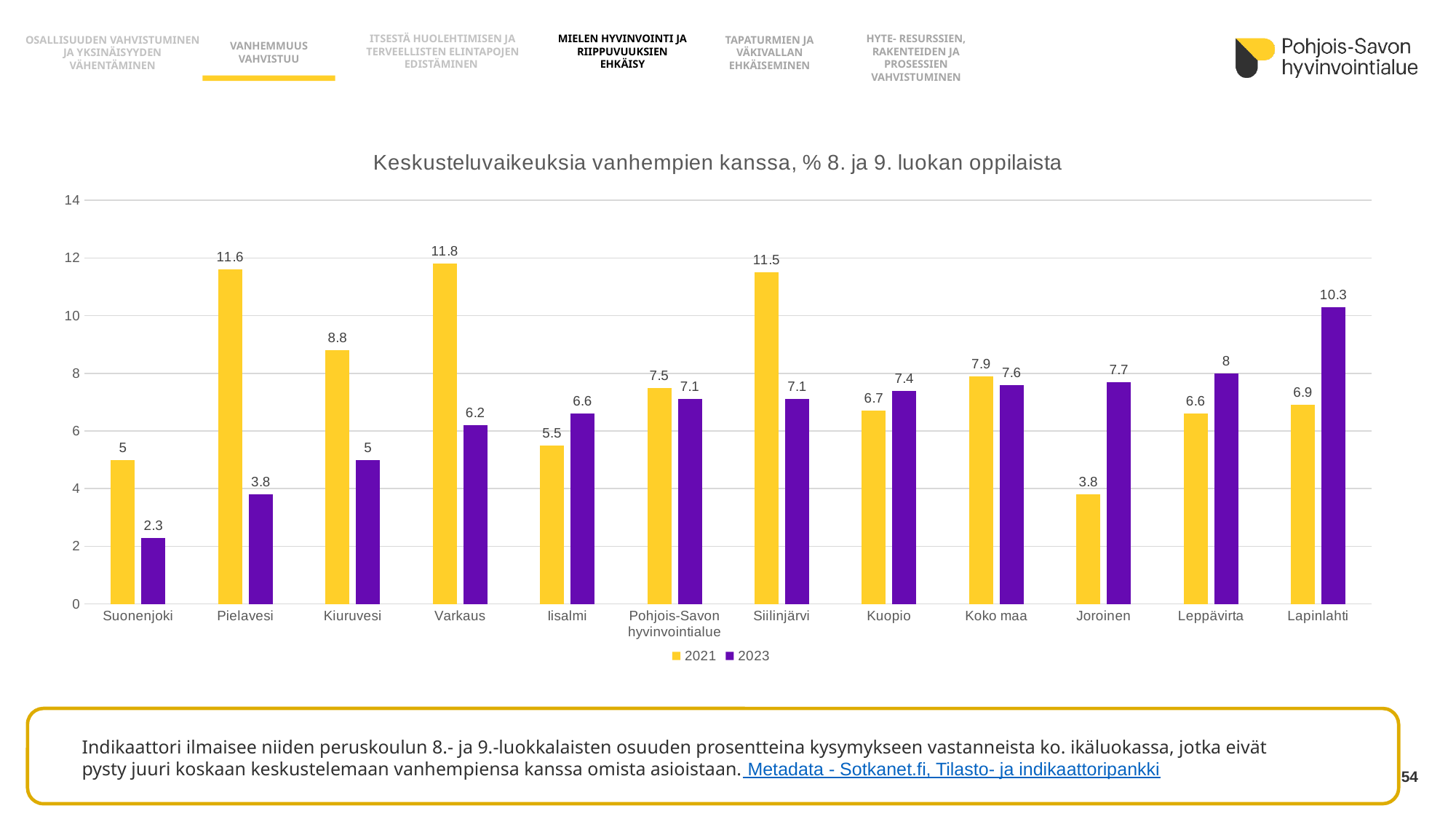
What is the title of the chart? Keskusteluvaikeuksia vanhempien kanssa, % 8. ja 9. luokan oppilaista Which municipality has the highest 2021 value? Varkaus What is the difference between the 2021 and 2023 values for Pielavesi? 7.8 What is the 2023 value for Suonenjoki? 2.3 What kind of chart is shown on the slide? Bar chart How many categories are shown on the x axis? 12 What is the 2021 value for Varkaus? 11.8 What is the 2023 value for Lapinlahti? 10.3 Which category has the highest 2023 value? Lapinlahti Which category has the lowest 2023 value? Suonenjoki Which is larger for Joroinen, the 2021 value or the 2023 value? 2023 How many series does the legend list? 2